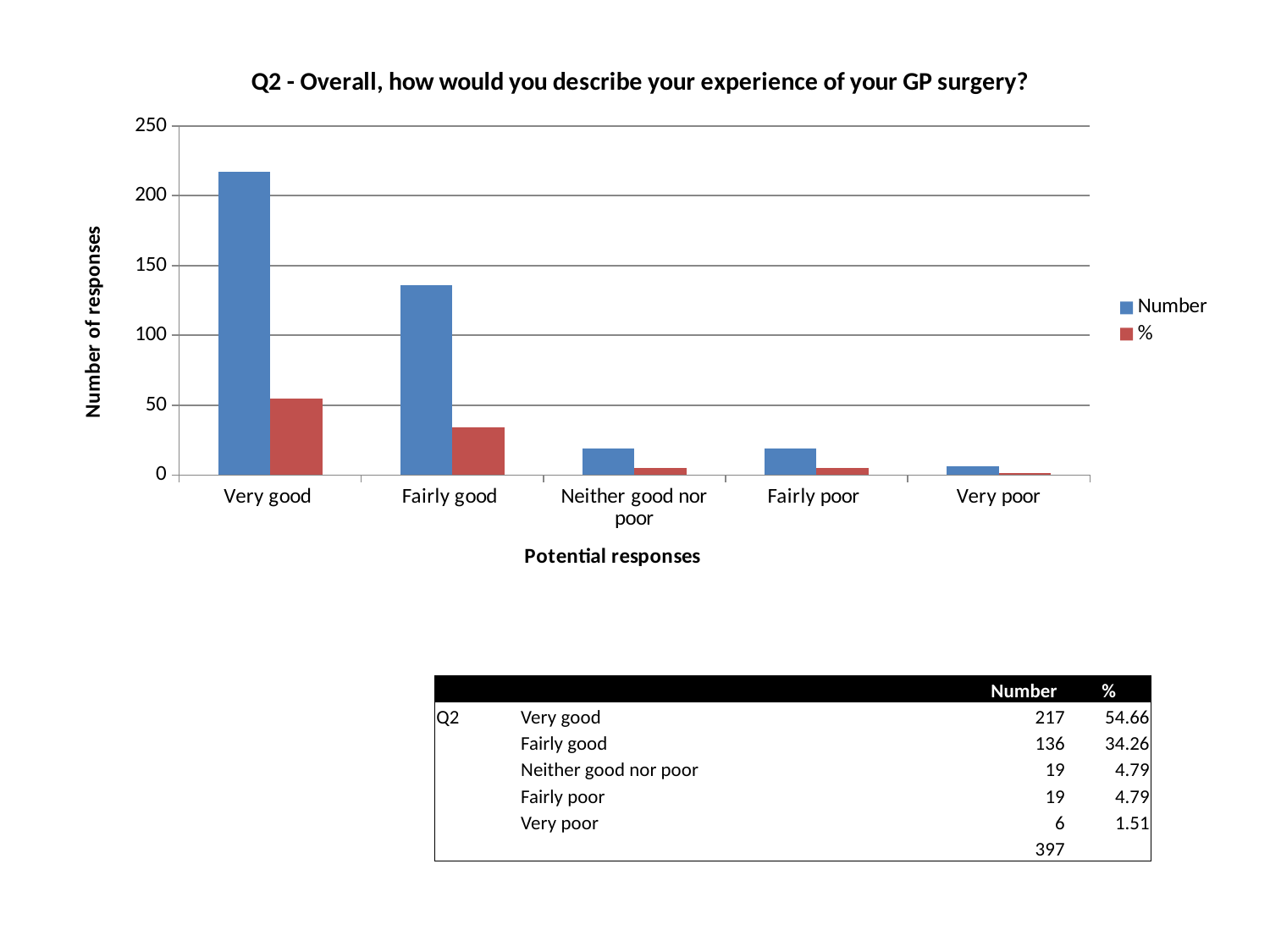
How many series does the chart legend list? 2 What is the Number value for Fairly good? 136 Which category has the lowest Number of responses? Very poor What is the title of the chart? Q2 - Overall, how would you describe your experience of your GP surgery? What kind of chart is shown on the slide? bar chart What is the % value for Very poor? 1.51 What is the difference between the Number values for Very good and Fairly good? 81 What is the Number value for Very good? 217 How many response categories are shown on the x axis of the chart? 5 Is the Number value for Very good greater or less than 200? greater Which category has the highest Number of responses? Very good Which is larger, the Number value for Fairly good or the Number value for Fairly poor? Fairly good